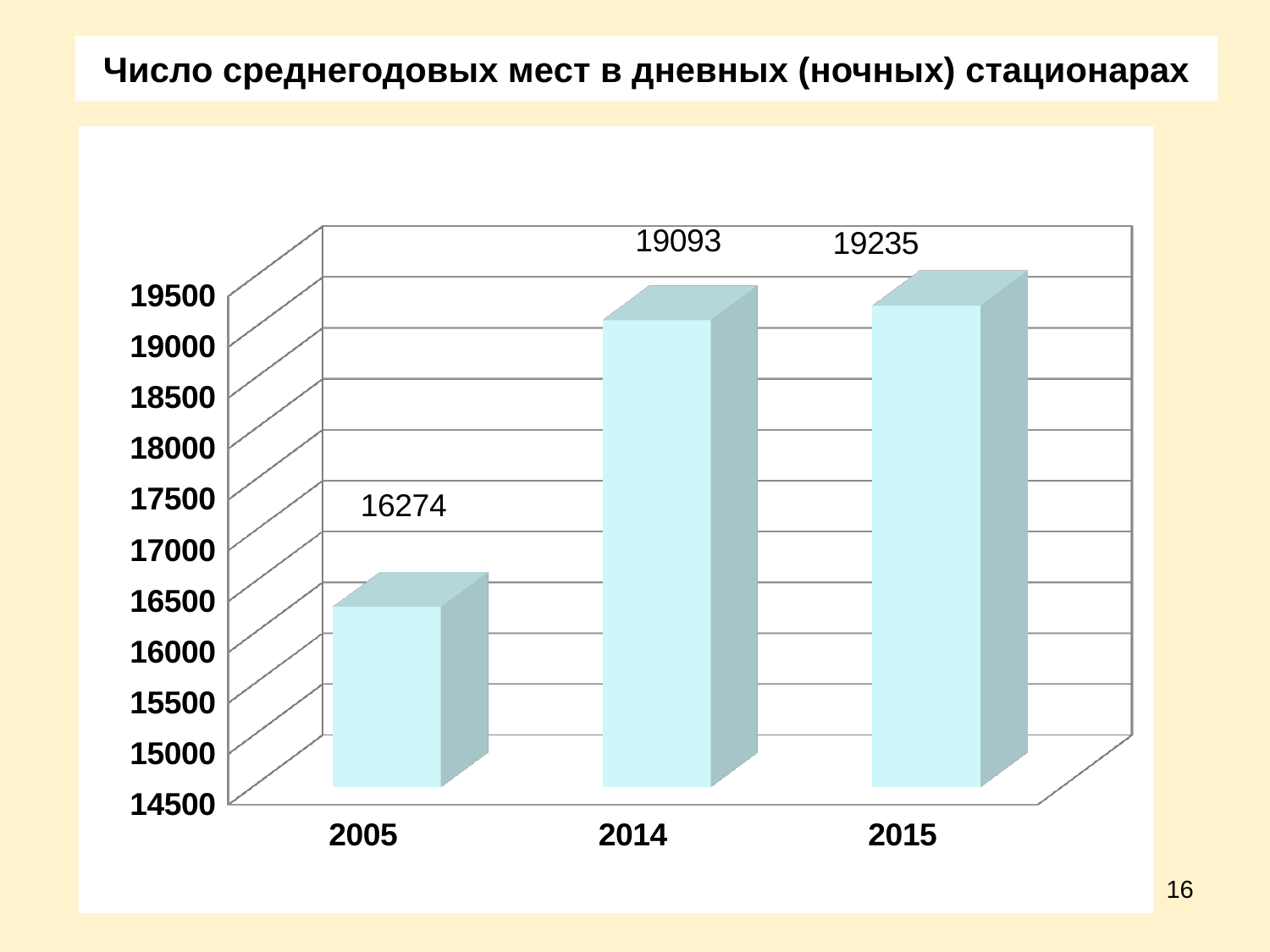
Is the value for 2005 greater or less than 17000? less Which year has the lowest value? 2005 What is the value for 2005? 16274 What is the value for 2015? 19235 What kind of chart is shown on the slide? bar chart Which year has the highest value? 2015 What is the value for 2014? 19093 What is the difference between the values for 2015 and 2014? 142 Do the values rise or fall from 2005 to 2015? rise What is the difference between the values for 2015 and 2005? 2961 Which is larger, the value for 2005 or the value for 2014? 2014 How many years are shown on the chart? 3